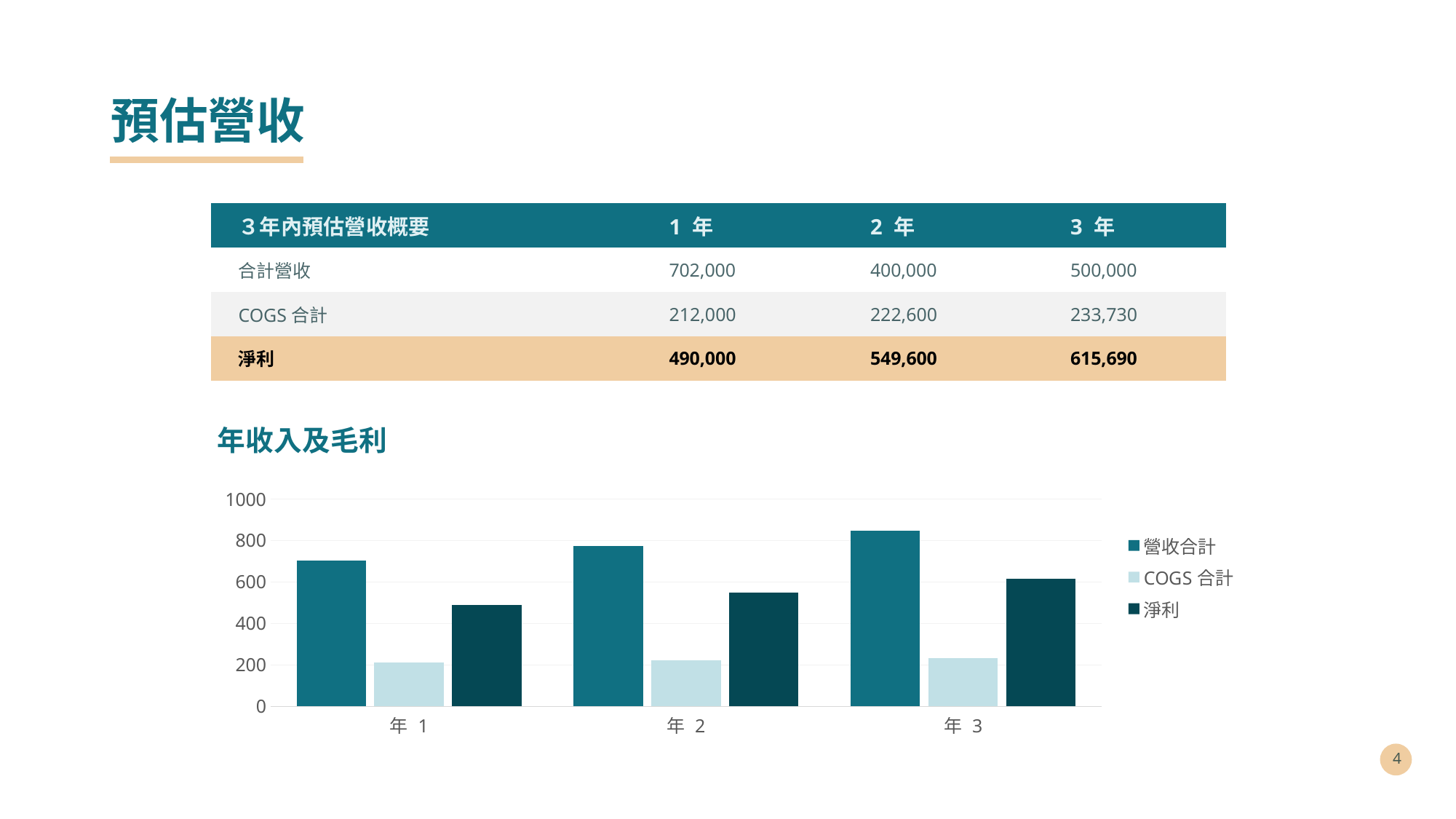
In the 年收入及毛利 chart, which year has the lowest 淨利 bar? 年 1 In the 年收入及毛利 chart, is the COGS 合計 value for 年 1 greater or less than 400? less In the 年收入及毛利 chart, which is larger for 年 2: 營收合計 or 淨利? 營收合計 How many series does the legend of the 年收入及毛利 chart list? 3 In the 年收入及毛利 chart, which year has the highest 營收合計 bar? 年 3 In the 年收入及毛利 chart, is the 營收合計 value for 年 1 greater or less than 800? less How many year categories are shown on the x axis of the 年收入及毛利 chart? 3 In the 年收入及毛利 chart, is the 營收合計 value for 年 3 greater or less than 800? greater Which series in the 年收入及毛利 chart is drawn in the lightest colour? COGS 合計 In the 年收入及毛利 chart, do the 營收合計 bars rise or fall from 年 1 to 年 3? rise What kind of chart is shown under the heading 年收入及毛利? bar chart